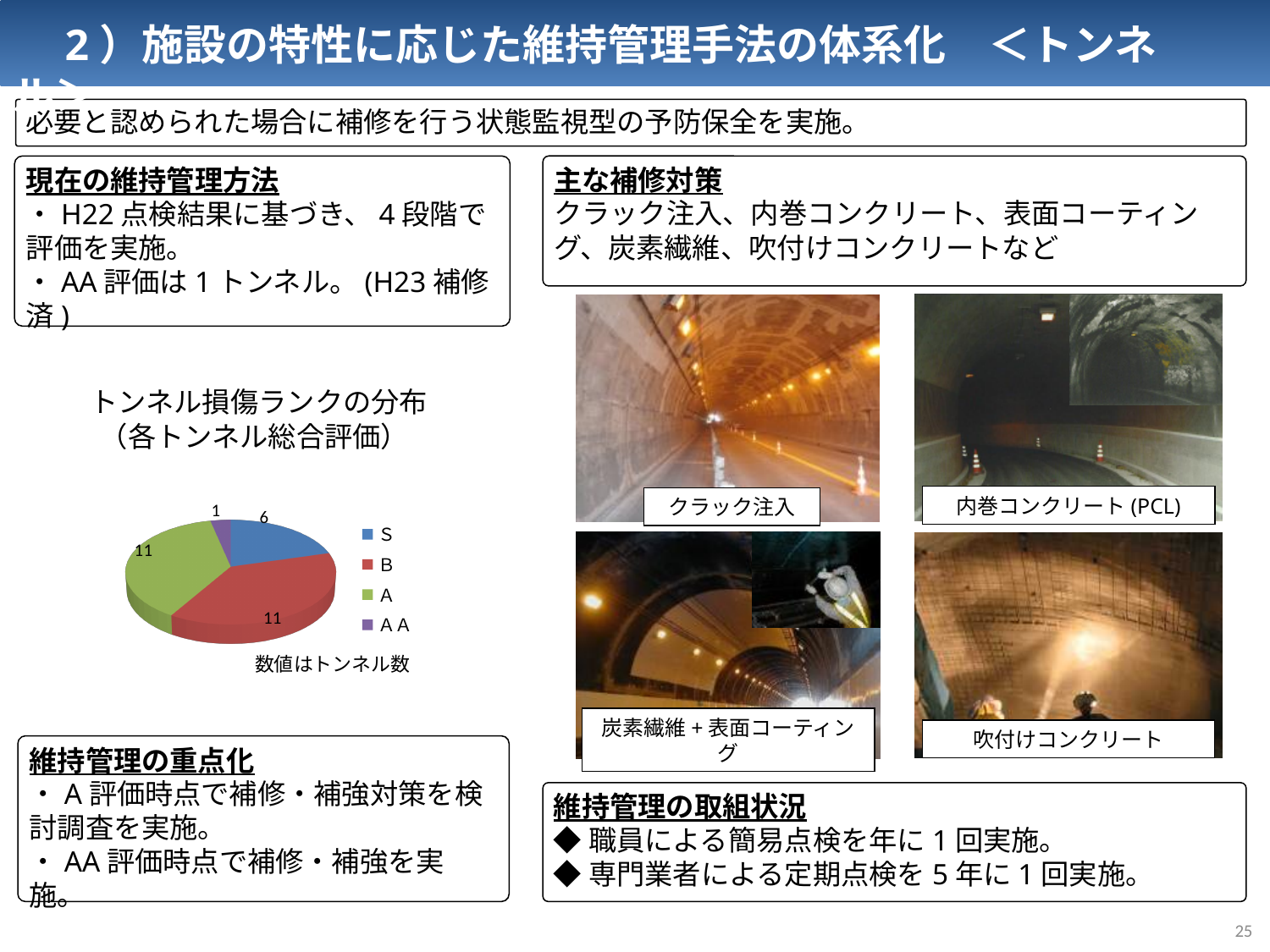
What kind of chart is shown on the slide? pie chart What is the total number of tunnels shown in the pie chart? 29 How many tunnels are in rank AA in the pie chart? 1 What is the difference between the number of tunnels in rank B and rank S? 5 How many categories does the pie chart show? 4 How many tunnels are in rank S in the pie chart? 6 What do the numbers on the pie chart represent, according to the note below it? トンネル数 How many tunnels are in rank A in the pie chart? 11 What is the title of the pie chart? トンネル損傷ランクの分布（各トンネル総合評価） Which rank has the fewest tunnels in the pie chart? AA Which has more tunnels, rank S or rank AA? S How many tunnels are in rank B in the pie chart? 11